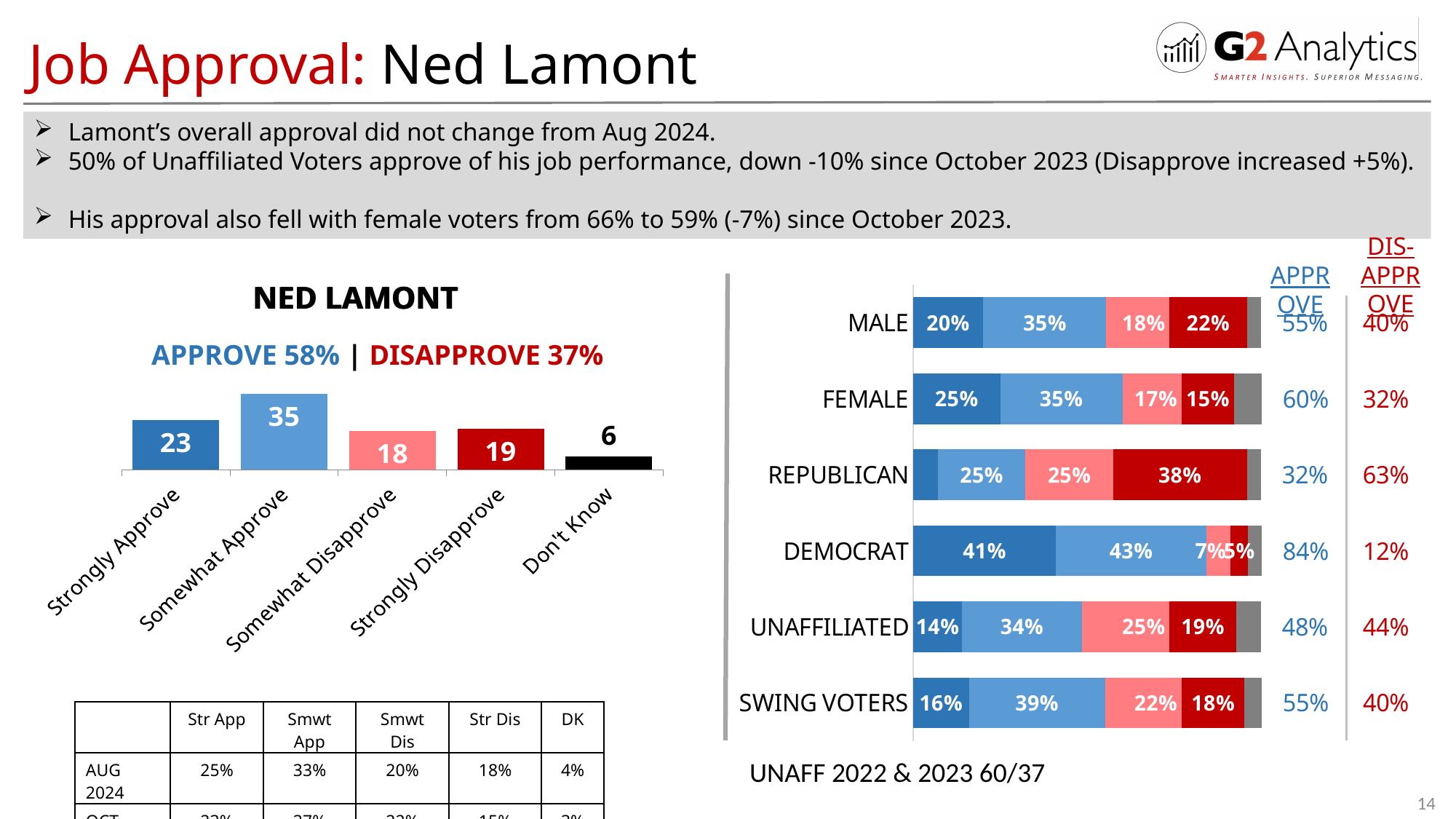
In the NED LAMONT bar chart on the left, what is the value for Strongly Approve? 23 In the NED LAMONT bar chart on the left, what is the difference between Somewhat Approve and Strongly Approve? 12 In the stacked bar chart on the right, what is the value of the first (dark blue) segment for DEMOCRAT? 41% In the stacked bar chart on the right, what is the difference between the light blue segment and the dark blue segment for SWING VOTERS? 23% In the stacked bar chart on the right, what is the value of the dark red segment for REPUBLICAN? 38% In the NED LAMONT bar chart on the left, which category has the lowest value? Don't Know In the NED LAMONT bar chart on the left, which category has the highest value? Somewhat Approve How many categories are shown in the NED LAMONT bar chart on the left? 5 In the stacked bar chart on the right, which is larger: the first (dark blue) segment for MALE or for FEMALE? FEMALE In the stacked bar chart on the right, what is the value of the light blue segment for UNAFFILIATED? 34% How many groups (bars) are shown in the stacked bar chart on the right? 6 What kind of chart is the NED LAMONT chart on the left? Bar chart